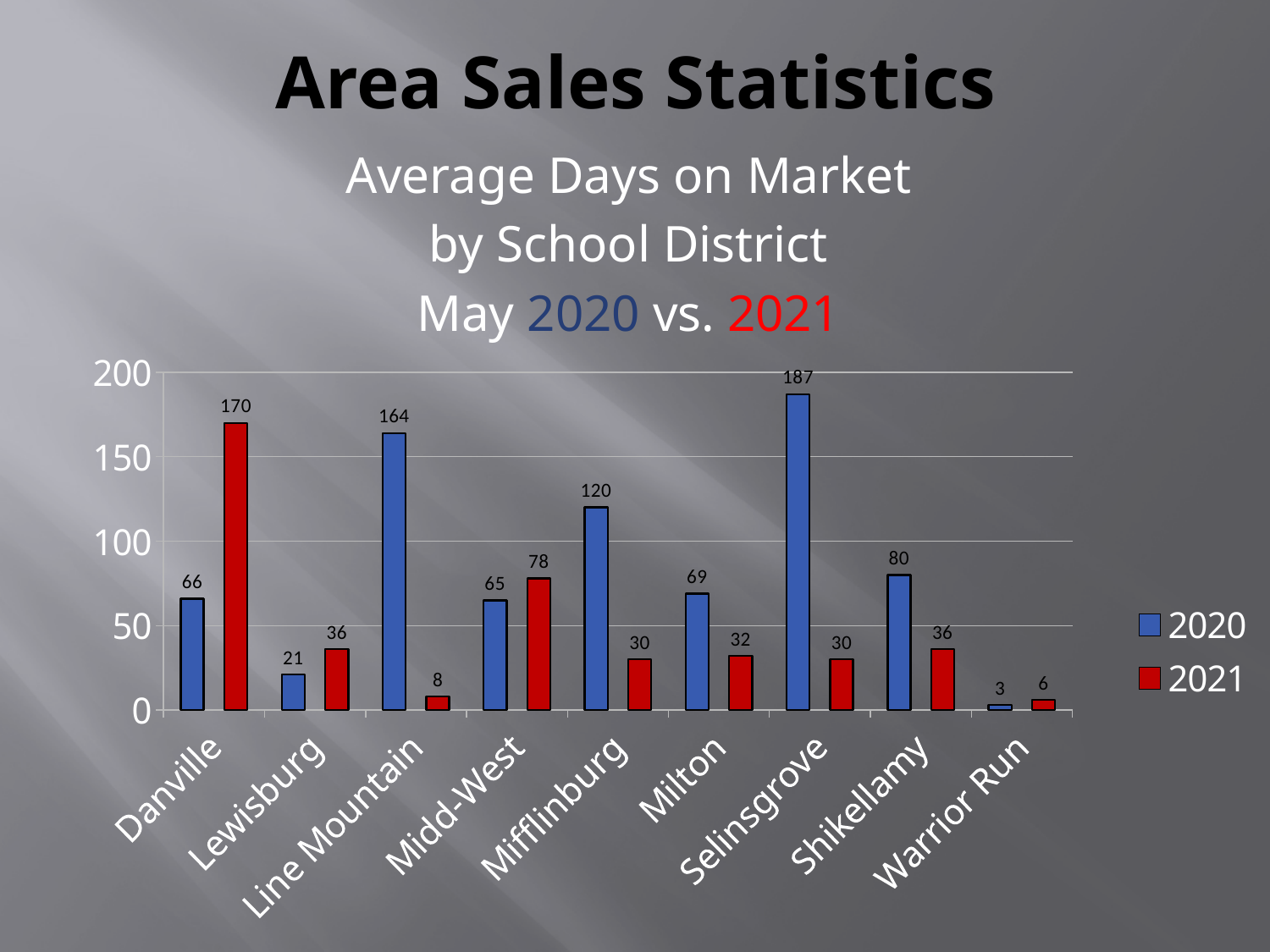
What is the 2021 value for Line Mountain? 8 What kind of chart is shown on the slide? bar chart Is the 2020 value for Mifflinburg greater or less than 100? greater Which school district has the lowest 2021 value? Warrior Run What is the 2021 average days on market for Danville? 170 How many school districts are shown on the x axis? 9 Which school district has the highest 2020 value? Selinsgrove What colour represents the 2021 series in the chart? red How many series does the legend list? 2 What is the difference between the 2020 and 2021 values for Line Mountain? 156 Which is larger for Midd-West, the 2020 value or the 2021 value? 2021 What is the 2020 average days on market for Selinsgrove? 187